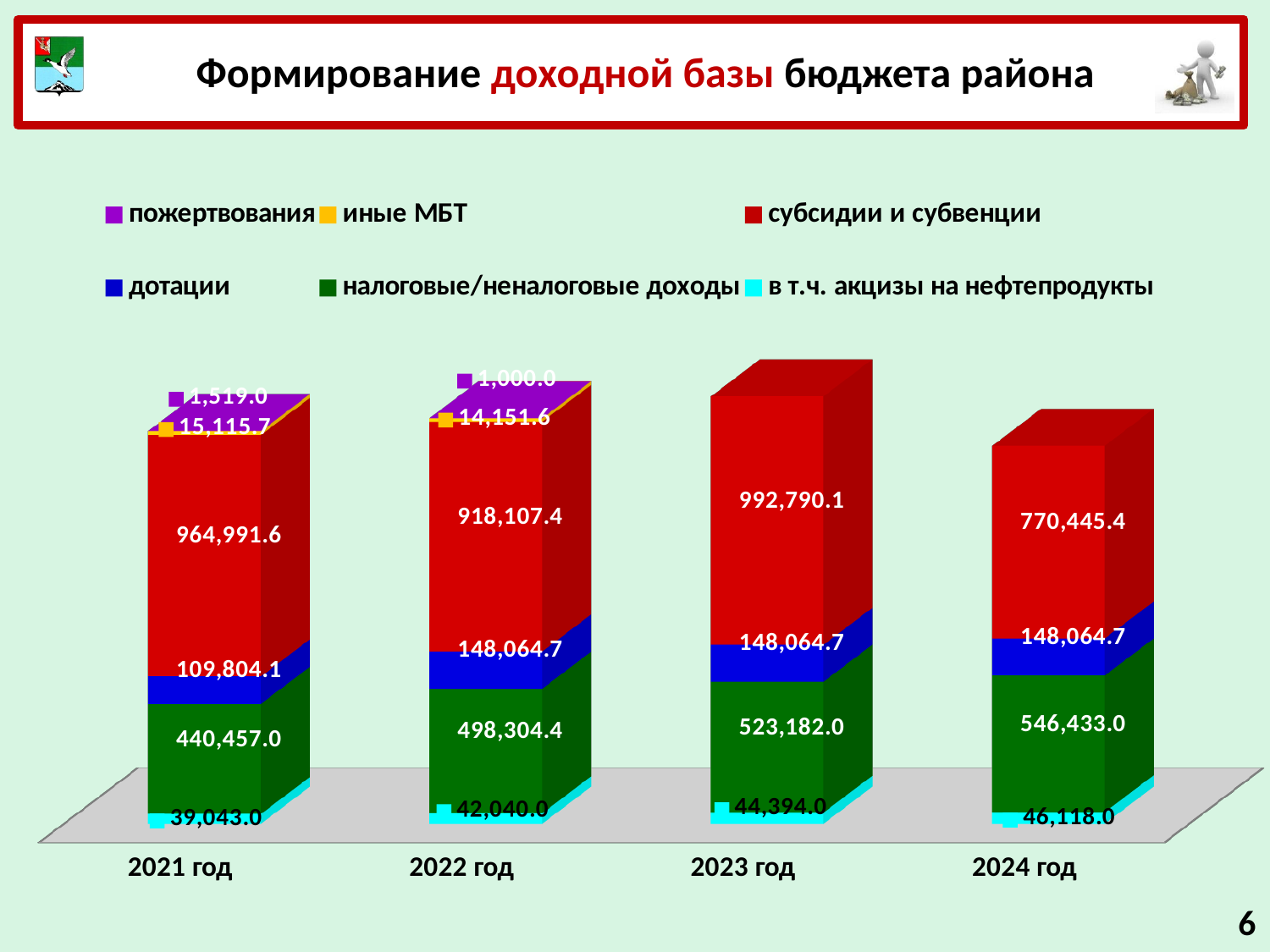
In which year is the value of субсидии и субвенции the lowest? 2024 год In which year is the value of субсидии и субвенции the highest? 2023 год Which is larger: налоговые/неналоговые доходы in 2022 год or in 2024 год? 2024 год How many years are shown on the x axis? 4 How many series does the legend list? 6 What is the value of в т.ч. акцизы на нефтепродукты for 2024 год? 46,118.0 What is the difference between субсидии и субвенции in 2023 год and 2024 год? 222,344.7 What is the value of налоговые/неналоговые доходы for 2021 год? 440,457.0 What is the value of иные МБТ for 2021 год? 15,115.7 Do the values of налоговые/неналоговые доходы rise or fall from 2021 год to 2024 год? rise What is the value of дотации for 2022 год? 148,064.7 What is the value of субсидии и субвенции for 2023 год? 992,790.1